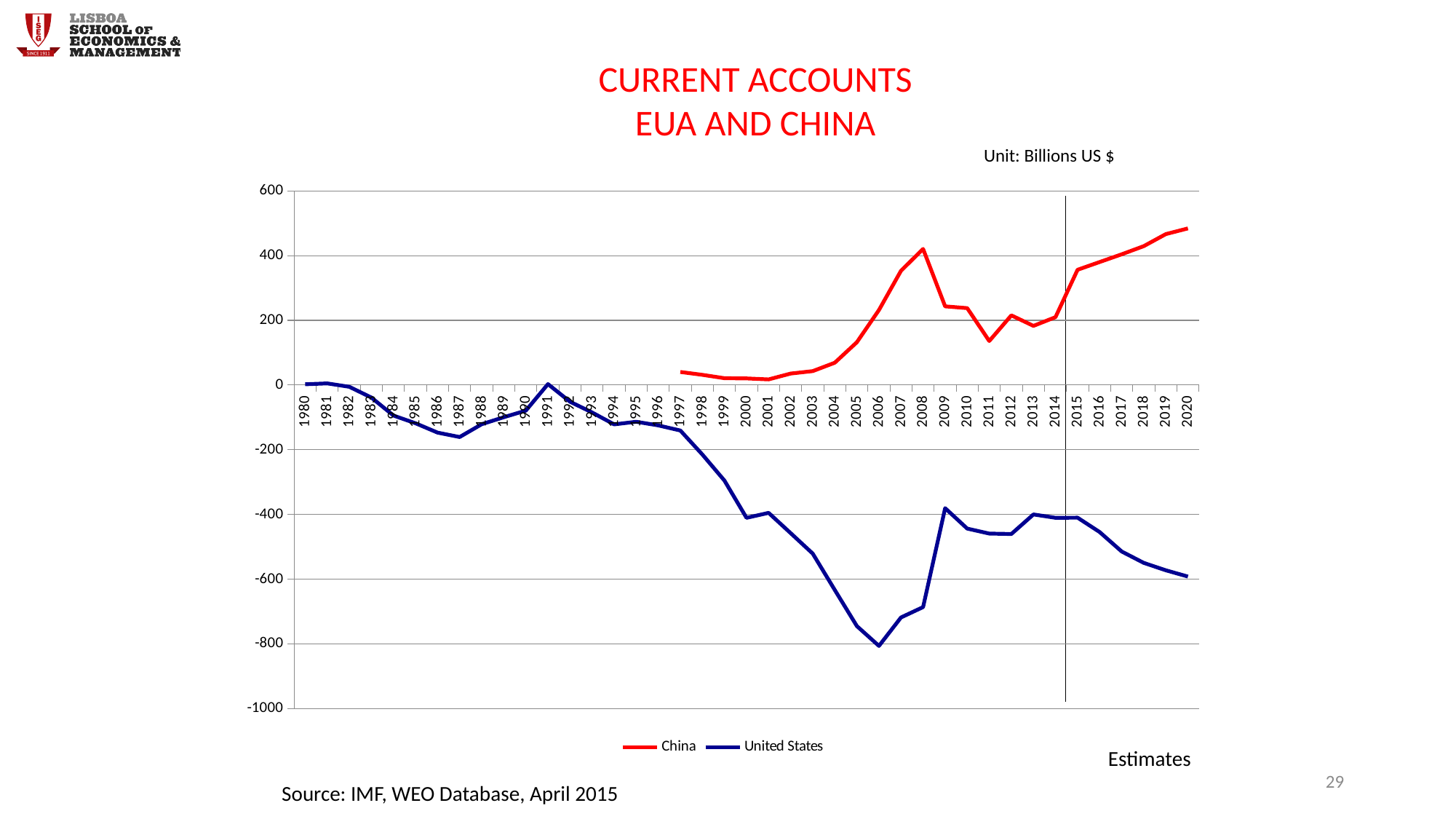
In which year does the China series reach its highest value? 2020 Which is larger for China: the value in 2008 or the value in 2011? 2008 Which two series are listed in the legend? China and United States What kind of chart is shown on the slide? line chart How many years are shown on the x axis? 41 Is the value for China in 2008 greater or less than 200? greater What unit is stated for the values in the chart? Billions US $ Does the United States series rise or fall from 2015 to 2020? fall Is the value for the United States in 2006 greater or less than -600? less How many series does the legend list? 2 In which year does the United States series reach its lowest value? 2006 Is the value for China in 2011 greater or less than 200? less